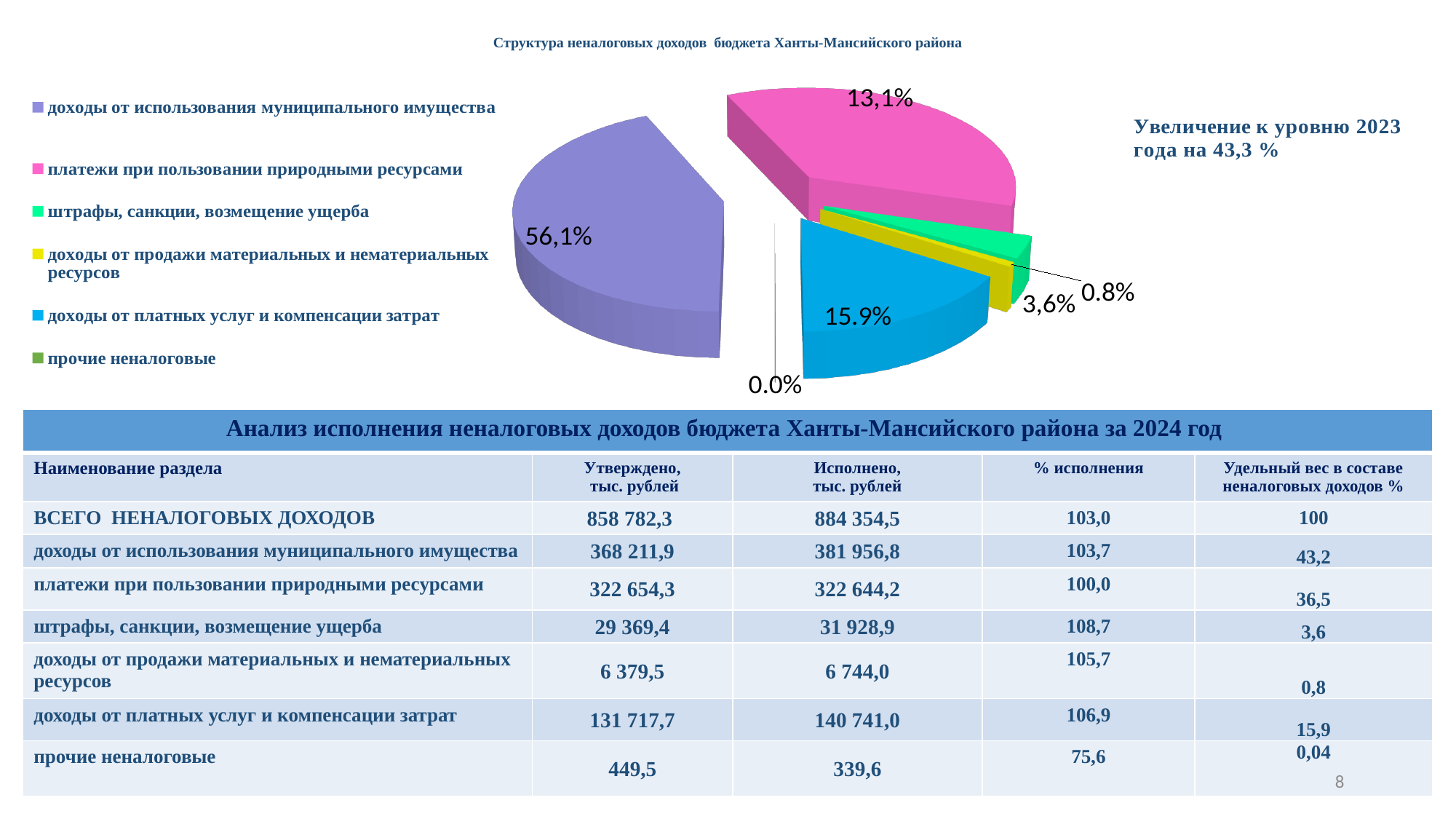
What kind of chart is shown on the slide? Pie chart What share of the pie is labelled for доходы от использования муниципального имущества? 56,1% What share of the pie is labelled for доходы от платных услуг и компенсации затрат? 15.9% Which category has the largest slice of the pie? доходы от использования муниципального имущества How many categories does the chart legend list? 6 What share of the pie is labelled for платежи при пользовании природными ресурсами? 13,1% What is the title of the chart? Структура неналоговых доходов бюджета Ханты-Мансийского района What share of the pie is labelled for прочие неналоговые? 0.0% Which category has the smallest slice of the pie? прочие неналоговые What colour is the slice for доходы от использования муниципального имущества? Purple